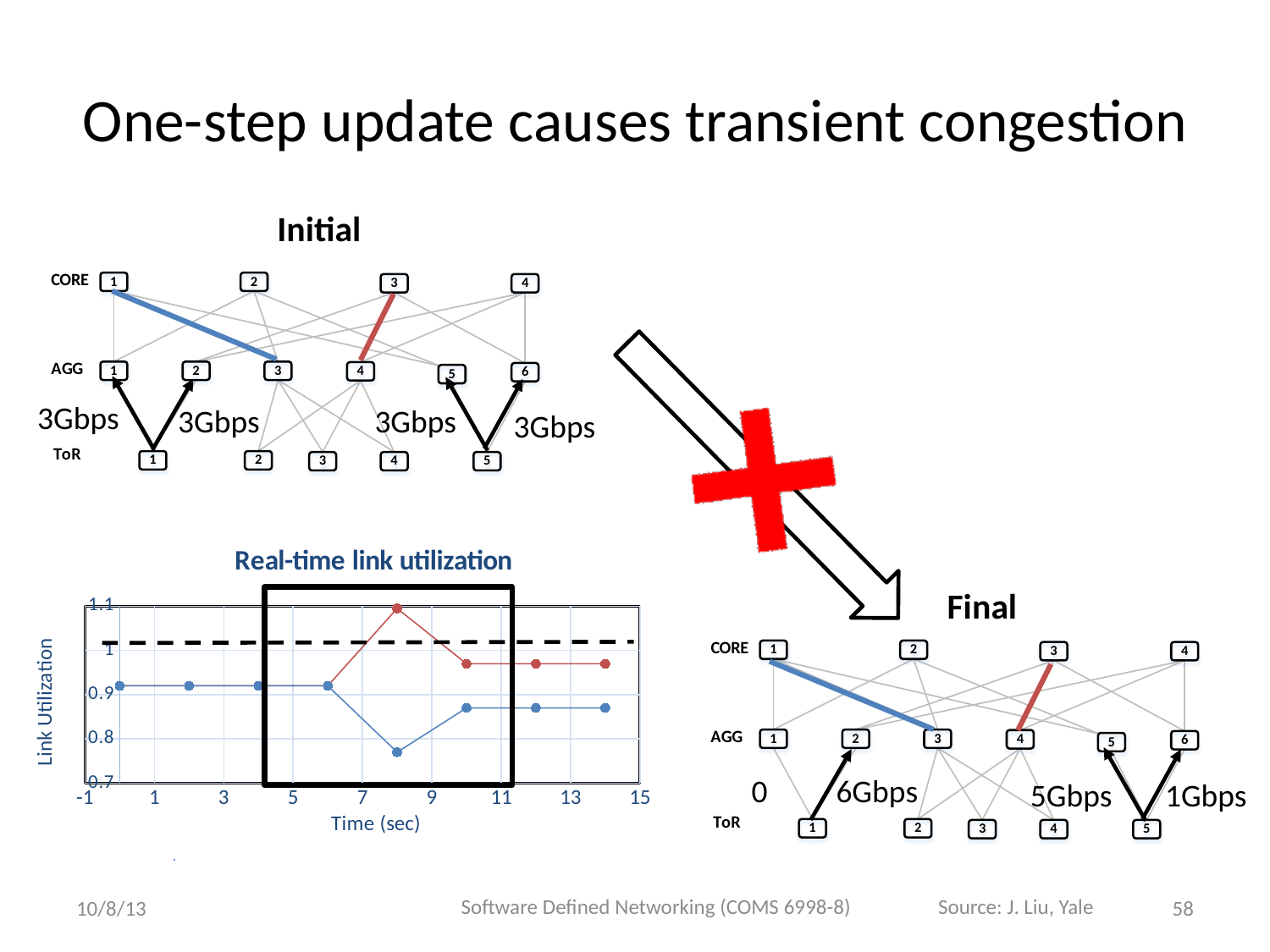
In the "Real-time link utilization" chart, is the red line's value at time 8 greater or less than 1? greater What is the label of the x axis of the "Real-time link utilization" chart? Time (sec) In the "Real-time link utilization" chart, is the blue line's value at time 12 greater or less than 1? less In the "Real-time link utilization" chart, at time 8, which line is higher, the red or the blue? red In the "Real-time link utilization" chart, at which time does the red line reach its highest value? 8 In the "Real-time link utilization" chart, does the blue line rise or fall between time 6 and time 8? fall What is the title of the chart on the slide? Real-time link utilization In the "Real-time link utilization" chart, at which time does the blue line reach its lowest value? 8 In the "Real-time link utilization" chart, is the blue line's value at time 8 greater or less than 0.8? less How many data points does each line in the "Real-time link utilization" chart have? 8 What kind of chart is the "Real-time link utilization" chart? line chart